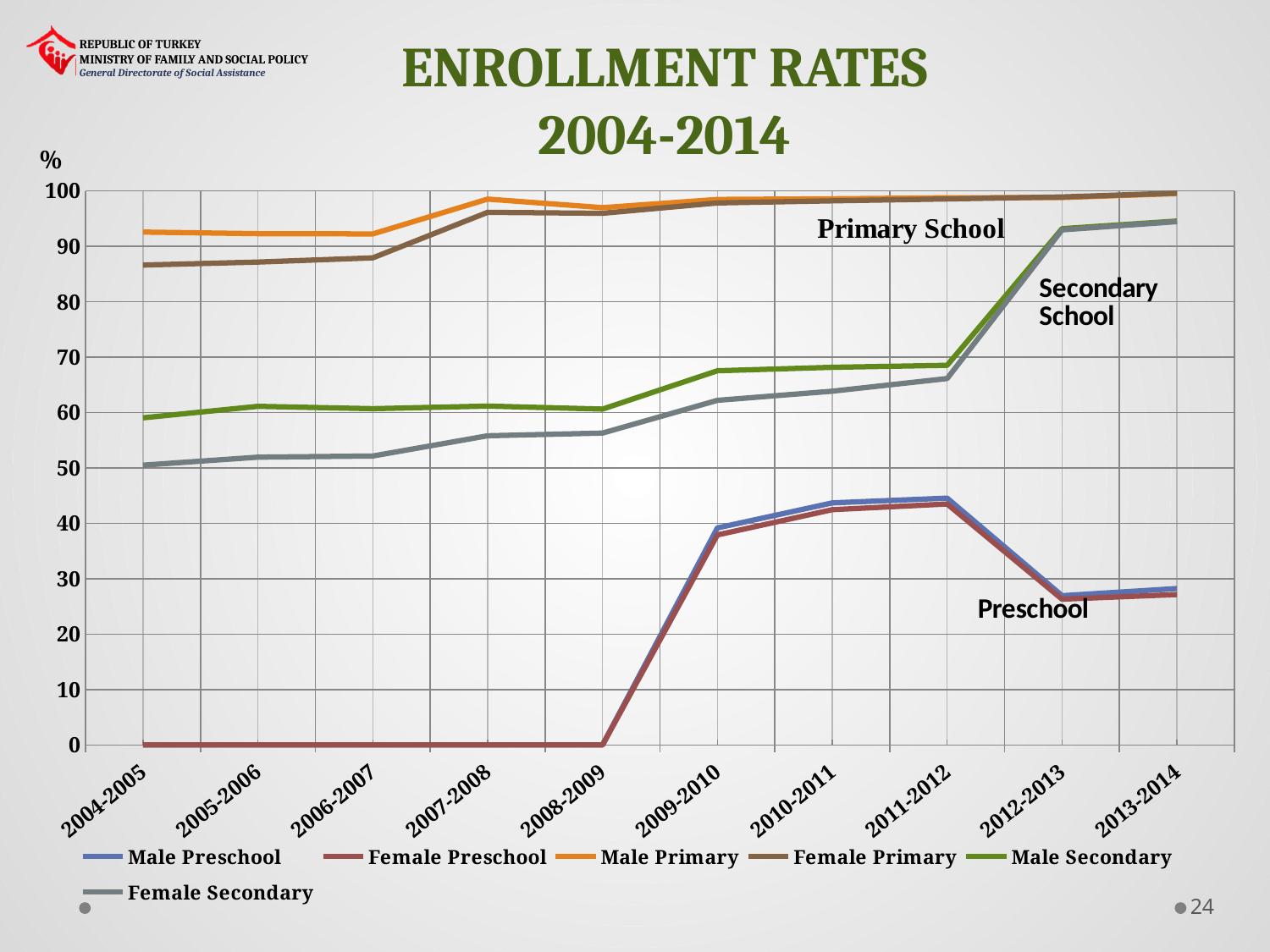
How many school-year categories are shown on the x axis? 10 Is the value for Female Primary in 2004-2005 greater or less than 90? less Does the Male Secondary line rise or fall from 2004-2005 to 2013-2014? rise What is the title of the chart? ENROLLMENT RATES 2004-2014 Which series has the highest value in 2004-2005? Male Primary Is the value for Male Preschool in 2011-2012 greater or less than 40? greater What kind of chart is shown on the slide? line chart Is the value for Female Secondary in 2013-2014 greater or less than 90? greater In 2008-2009, which is higher: Male Secondary or Female Secondary? Male Secondary How many series does the legend list? 6 What is the value for Female Preschool in 2006-2007? 0